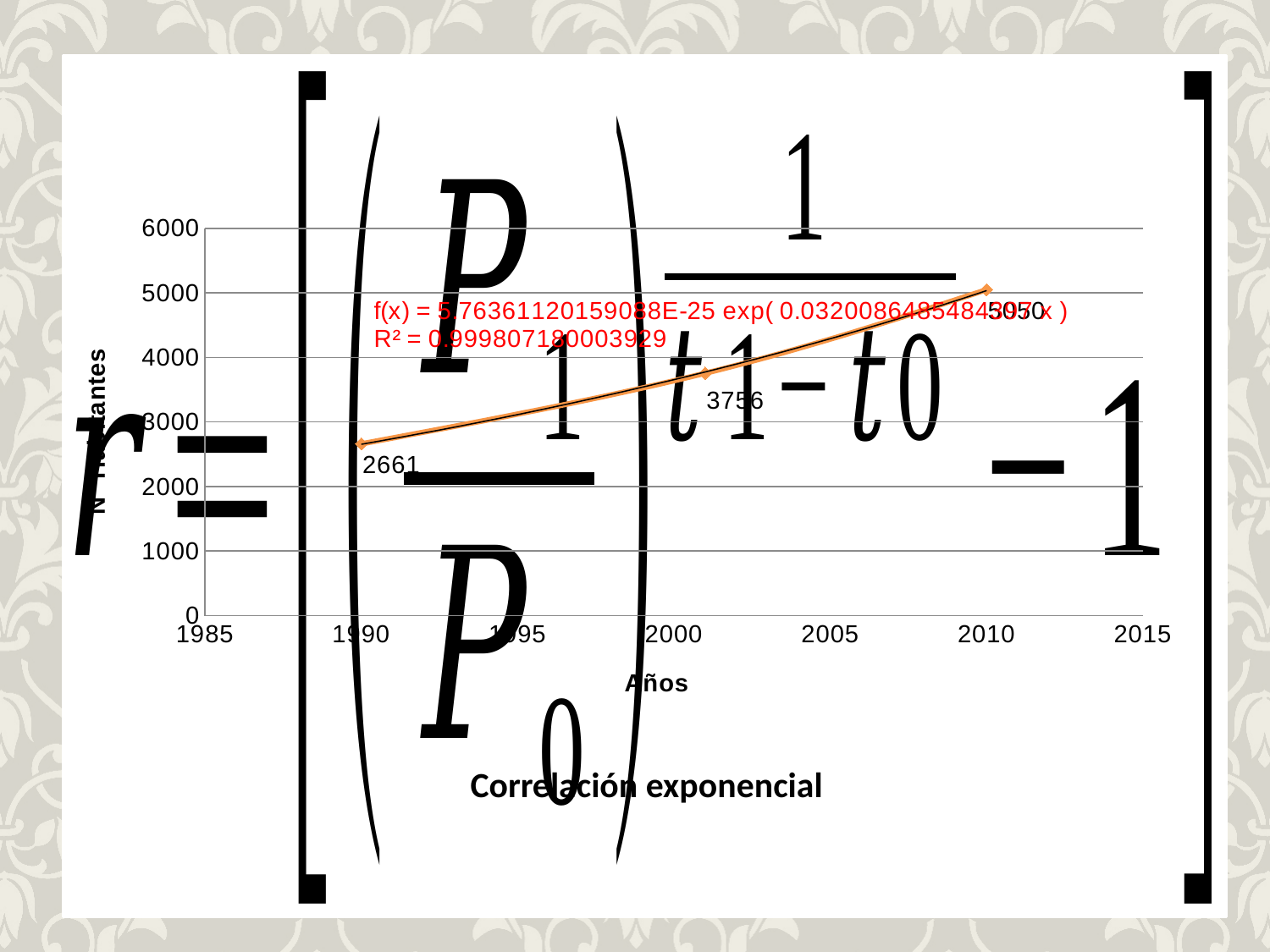
What is the difference between the data point labelled 3756 and the data point labelled 2661? 1095 How many data points are plotted on the chart? 3 Which is larger: the value at 1990 or the value of the point just after 2000? the point just after 2000 What is the value of the data point labelled just after 2000 on the x axis? 3756 Is the value of the data point at 1990 greater or less than 3000? less Which data point has the lowest value? 1990 (2661) What is the value of the data point at 1990? 2661 What kind of chart is shown? scatter chart with an exponential trendline Is the value of the data point at 2010 greater or less than 4000? greater What is the title of the chart? Correlación exponencial What is the label of the x axis? Años Do the values rise or fall as the years increase? rise